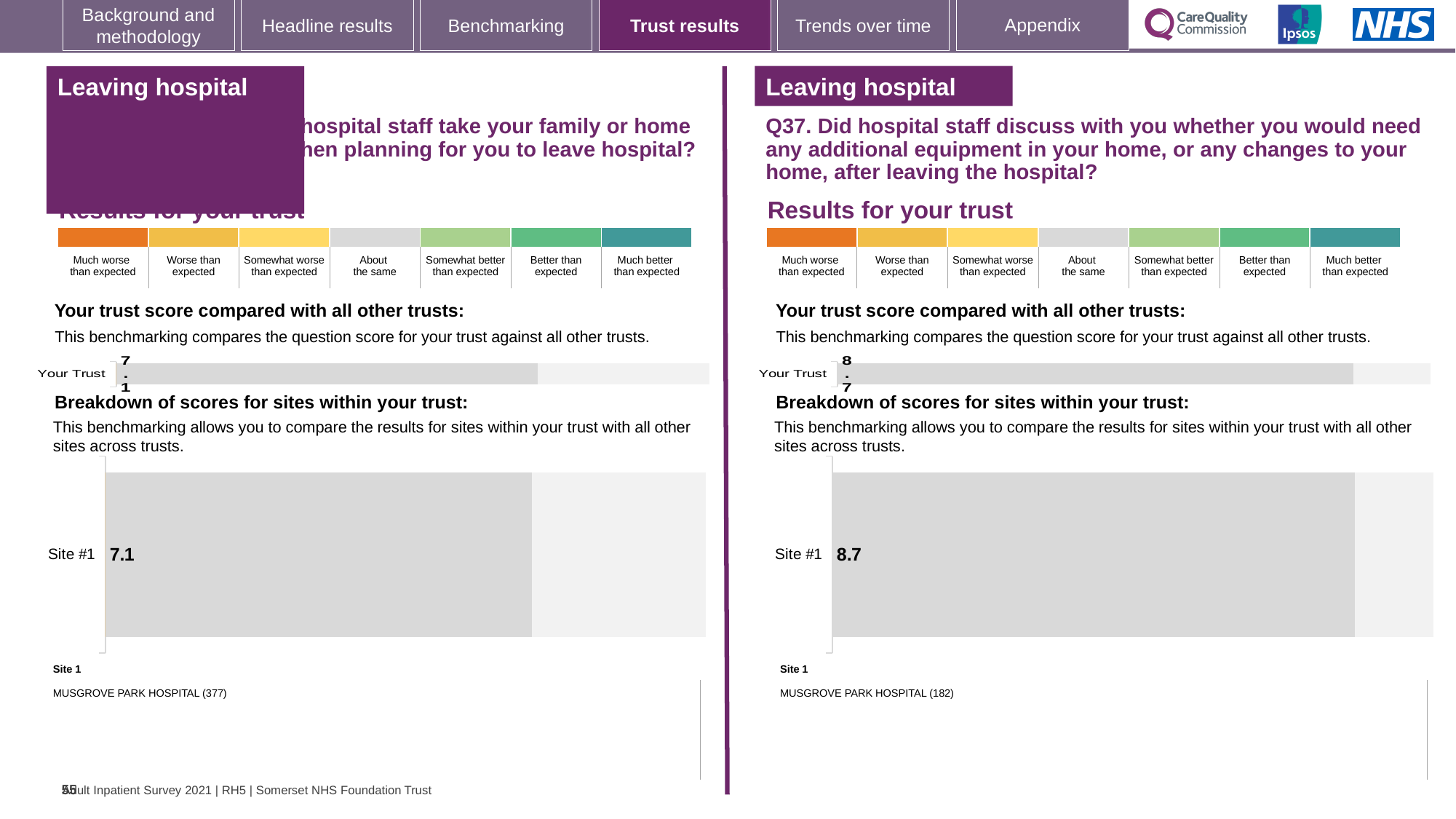
Which is larger: the Site #1 score in the left-hand site breakdown chart or the Site #1 score in the right-hand (Q37) site breakdown chart? The right-hand (Q37) chart Which site is labelled as Site 1 beneath the right-hand (Q37) site breakdown chart? MUSGROVE PARK HOSPITAL (182) What is the difference between the Your Trust score in the right-hand (Q37) chart and the Your Trust score in the left-hand chart? 1.6 On the left half of the slide, in the 'Breakdown of scores for sites within your trust' chart, what is the score for Site #1? 7.1 On the right half of the slide (Q37), in the 'Your trust score compared with all other trusts' chart, what is the value shown for Your Trust? 8.7 On the right half of the slide (Q37), in the 'Breakdown of scores for sites within your trust' chart, what is the score for Site #1? 8.7 How many sites are plotted in the left-hand 'Breakdown of scores for sites within your trust' chart? 1 Which site is labelled as Site 1 beneath the left-hand site breakdown chart? MUSGROVE PARK HOSPITAL (377) What type of chart is used for the 'Your Trust' score on the right half of the slide? Bar chart How many sites are plotted in the right-hand (Q37) 'Breakdown of scores for sites within your trust' chart? 1 On the left half of the slide, in the 'Your trust score compared with all other trusts' chart, what is the value shown for Your Trust? 7.1 What type of chart is used for the site breakdown on the left half of the slide? Bar chart